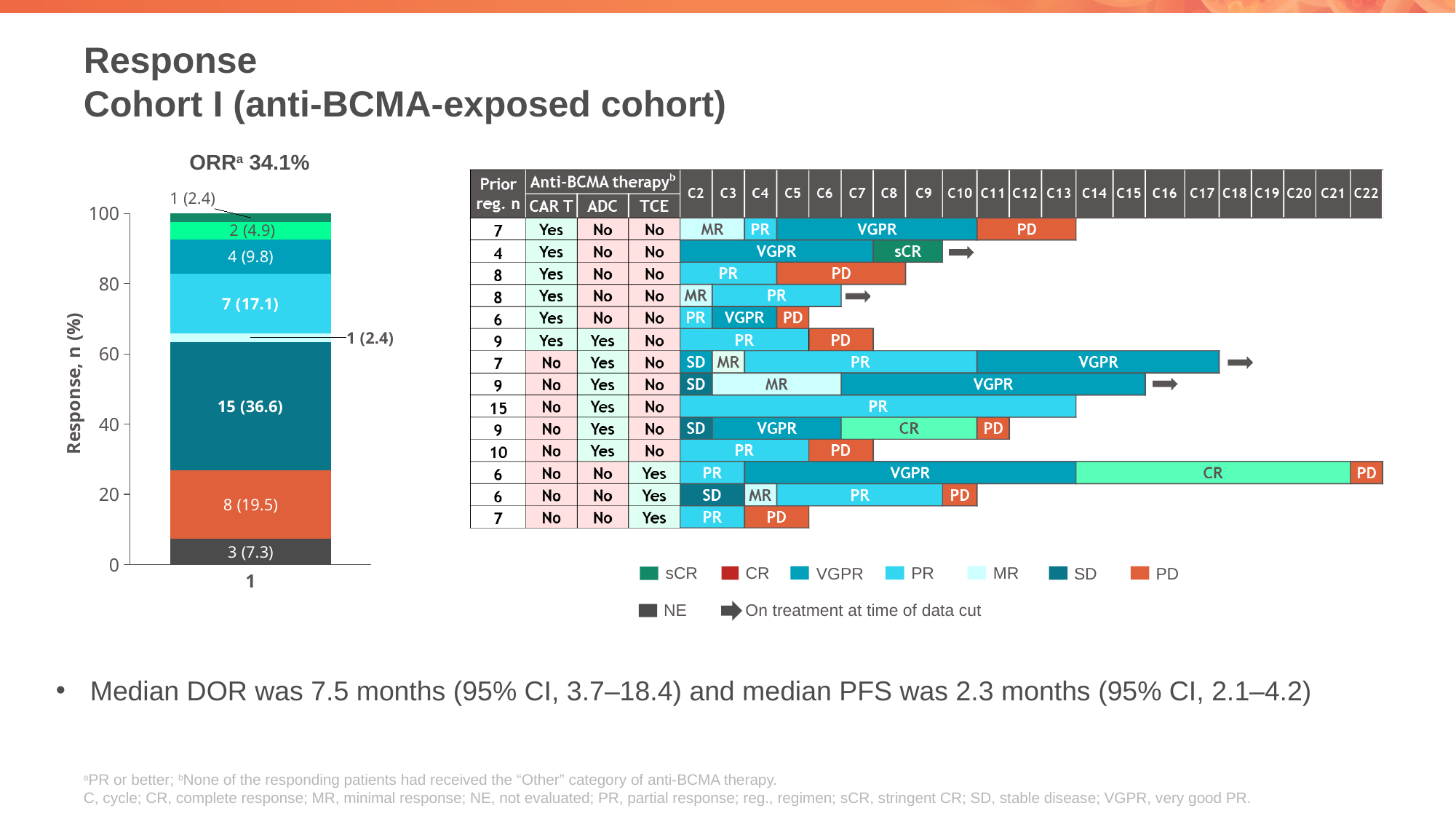
What kind of chart is shown on the left of the slide? Stacked bar chart In the stacked bar chart on the left, which segment represents more patients: the one labelled 7 (17.1) or the one labelled 4 (9.8)? 7 (17.1) In the swimmer plot on the right, what is the last cycle column shown in the header? C22 What is the y-axis label of the stacked bar chart on the left? Response, n (%) In the stacked bar chart on the left, what is the value printed on the orange (PD) segment? 8 (19.5) How many response categories does the legend of the swimmer plot on the right list (excluding the arrow symbol)? 8 How many segments make up the stacked bar in the chart on the left? 8 What ORR is stated above the stacked bar chart on the left? 34.1% In the stacked bar chart on the left, what is the difference in patient count between the segment labelled 15 (36.6) and the segment labelled 8 (19.5)? 7 How many patient rows are shown in the swimmer plot on the right? 14 In the stacked bar chart on the left, what is the value printed on the largest segment? 15 (36.6) In the stacked bar chart on the left, what is the total number of patients across all segments? 41